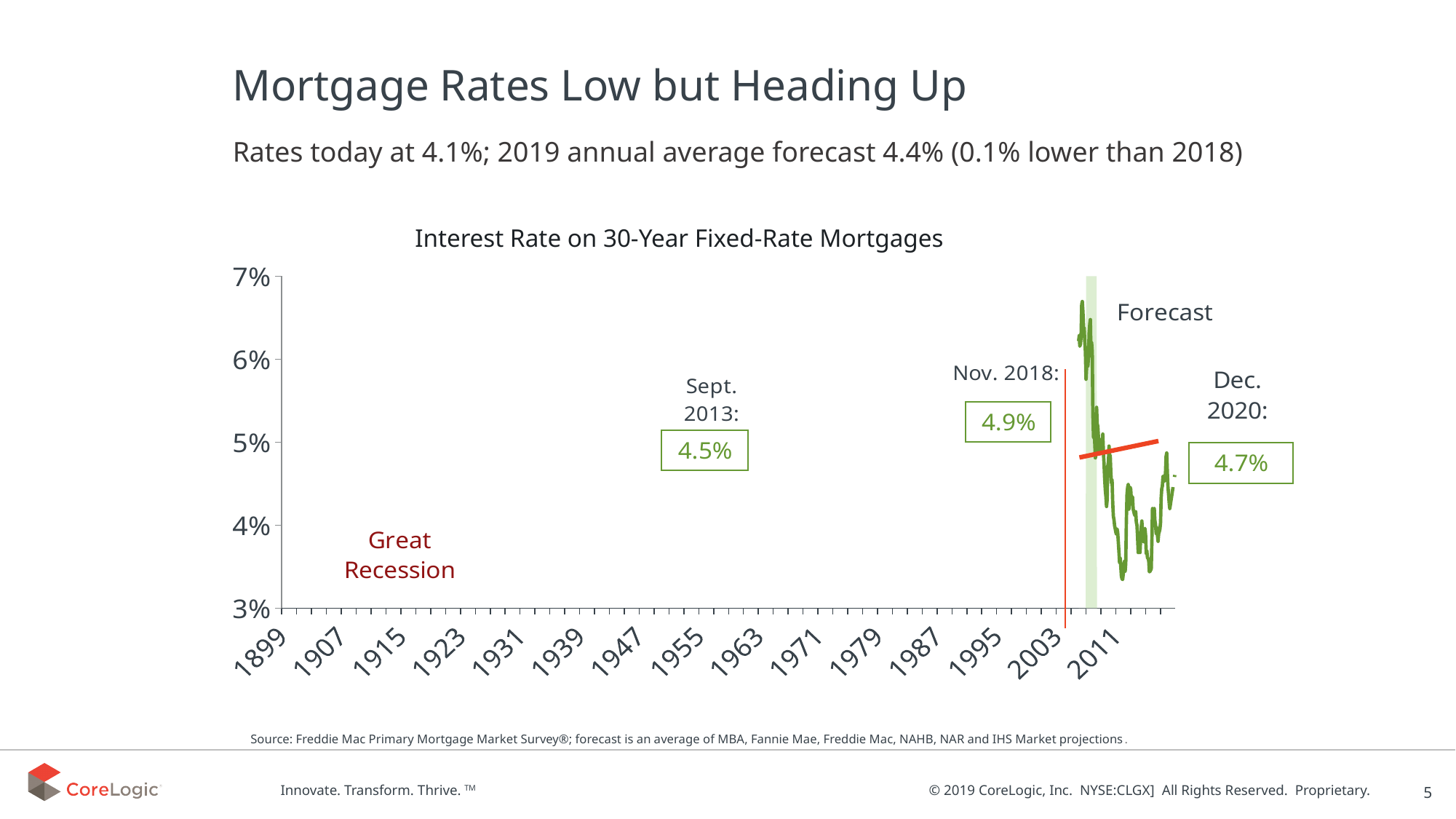
What interest rate is labelled for Nov. 2018? 4.9% What interest rate is labelled for Sept. 2013? 4.5% What is the highest value shown on the vertical axis? 7% What kind of chart is shown on the slide? line chart Of the three labelled rates (Sept. 2013, Nov. 2018, Dec. 2020), which is the highest? Nov. 2018 Of the three labelled rates (Sept. 2013, Nov. 2018, Dec. 2020), which is the lowest? Sept. 2013 What is the difference between the Nov. 2018 rate and the Sept. 2013 rate? 0.4% What is the difference between the Dec. 2020 forecast and the Sept. 2013 rate? 0.2% Is the peak of the plotted line greater or less than 6%? greater What interest rate is forecast for Dec. 2020? 4.7% What is the title of the chart? Interest Rate on 30-Year Fixed-Rate Mortgages Which is higher, the labelled rate for Nov. 2018 or the forecast for Dec. 2020? Nov. 2018